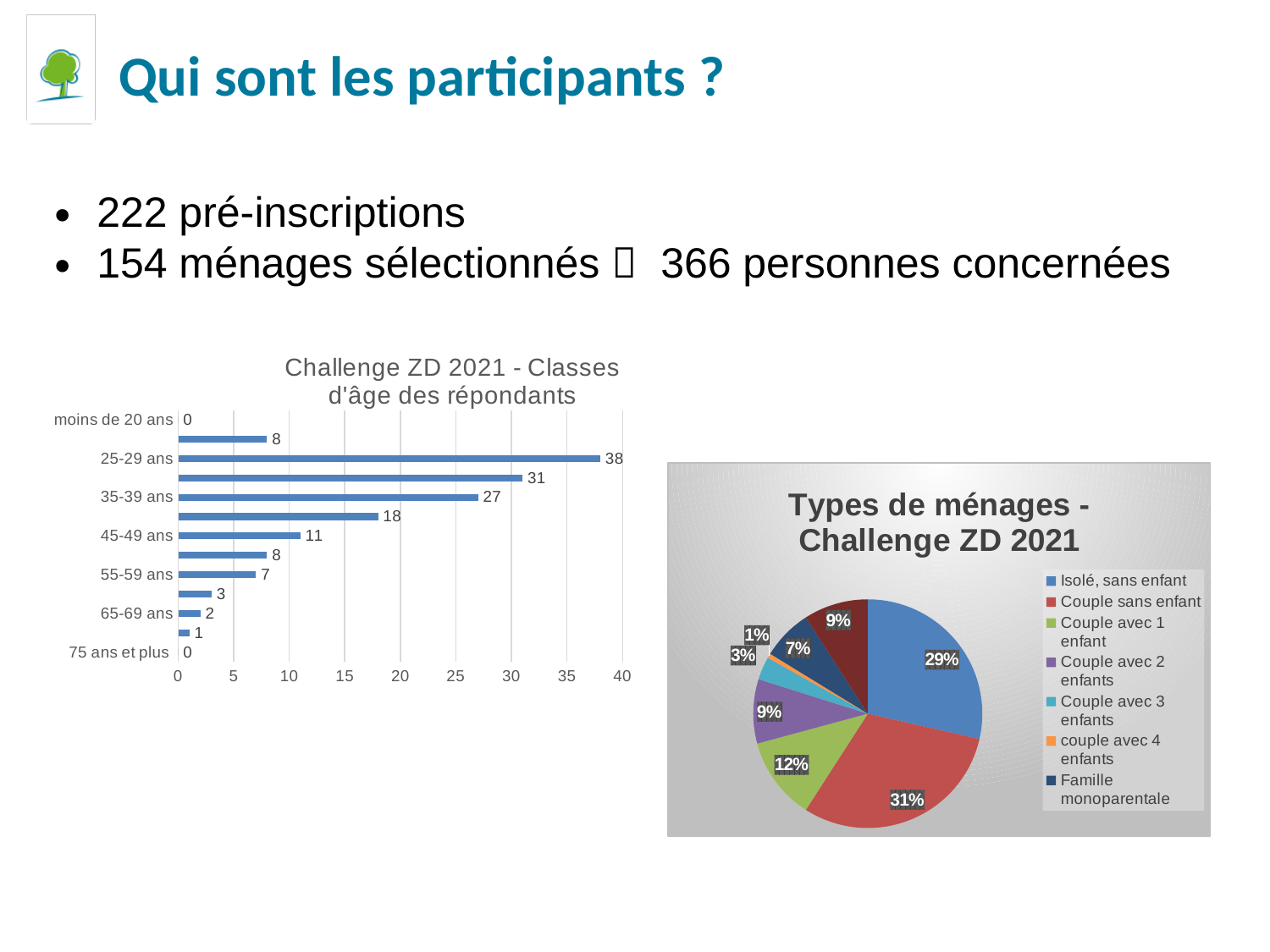
In the bar chart 'Challenge ZD 2021 - Classes d'âge des répondants', what is the value for 35-39 ans? 27 In the pie chart 'Types de ménages - Challenge ZD 2021', what share is 'Couple sans enfant'? 31% In the pie chart 'Types de ménages - Challenge ZD 2021', which household type has the largest slice? Couple sans enfant In the bar chart 'Challenge ZD 2021 - Classes d'âge des répondants', which age class has the highest value? 25-29 ans In the bar chart 'Challenge ZD 2021 - Classes d'âge des répondants', what is the difference between the values for 25-29 ans and 35-39 ans? 11 In the pie chart 'Types de ménages - Challenge ZD 2021', what share is 'Isolé, sans enfant'? 29% In the bar chart 'Challenge ZD 2021 - Classes d'âge des répondants', what is the value for 45-49 ans? 11 How many bars are plotted in the bar chart 'Challenge ZD 2021 - Classes d'âge des répondants'? 13 In the bar chart 'Challenge ZD 2021 - Classes d'âge des répondants', what is the value for 25-29 ans? 38 What kind of chart is 'Challenge ZD 2021 - Classes d'âge des répondants'? Bar chart In the bar chart 'Challenge ZD 2021 - Classes d'âge des répondants', which has a larger value, 55-59 ans or 65-69 ans? 55-59 ans